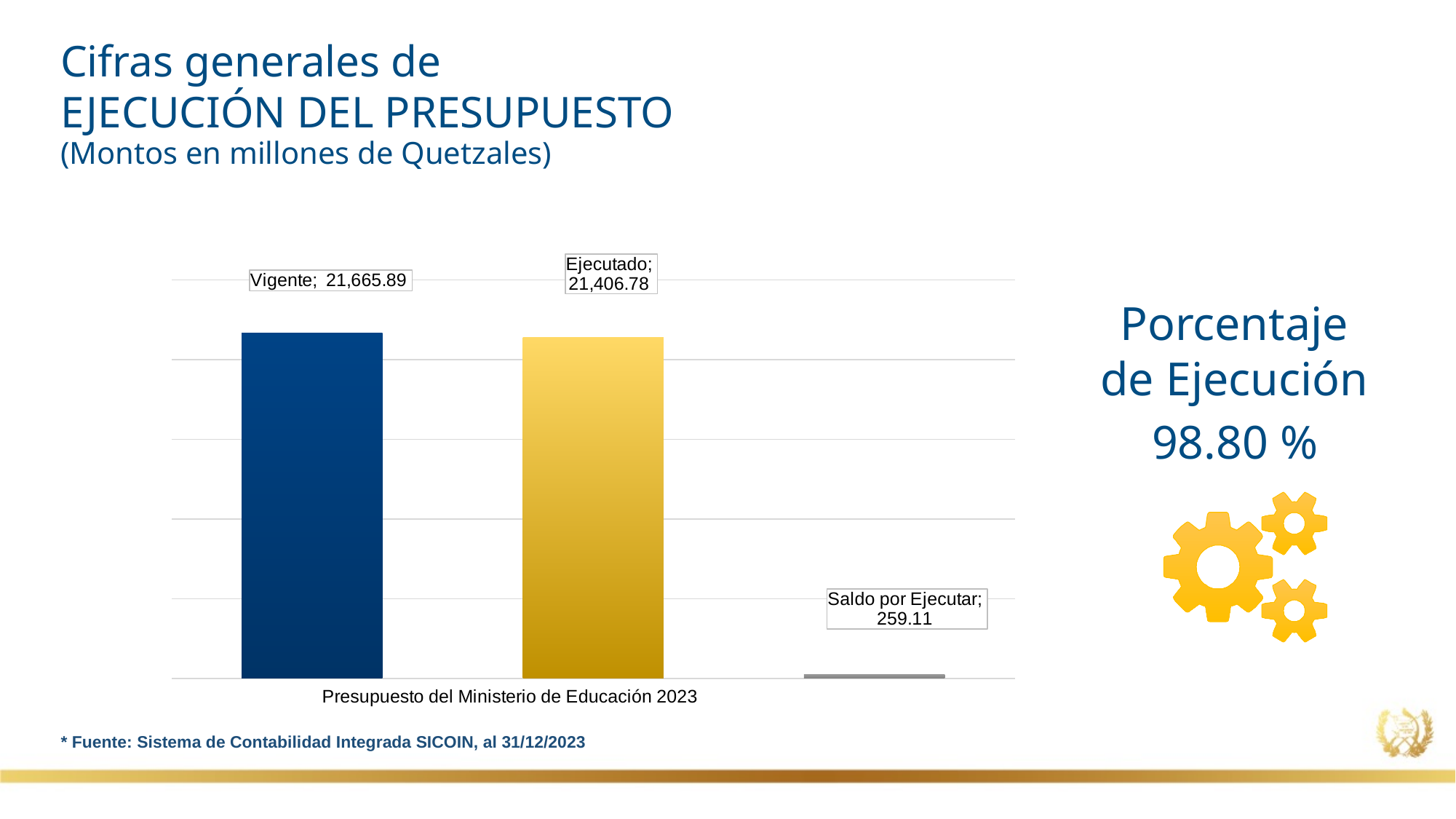
What is the value of the Vigente bar? 21,665.89 What colour is the Vigente bar? Dark blue What is the value of the Ejecutado bar? 21,406.78 What is the difference between the Vigente and Ejecutado values? 259.11 What is the difference between the Ejecutado and Saldo por Ejecutar values? 21,147.67 Which bar has the highest value? Vigente Which bar has the lowest value? Saldo por Ejecutar What is the label shown on the x axis of the chart? Presupuesto del Ministerio de Educación 2023 What is the value of the Saldo por Ejecutar bar? 259.11 Which is larger, Vigente or Ejecutado? Vigente How many bars are plotted in the chart? 3 What kind of chart is shown on the slide? Bar chart